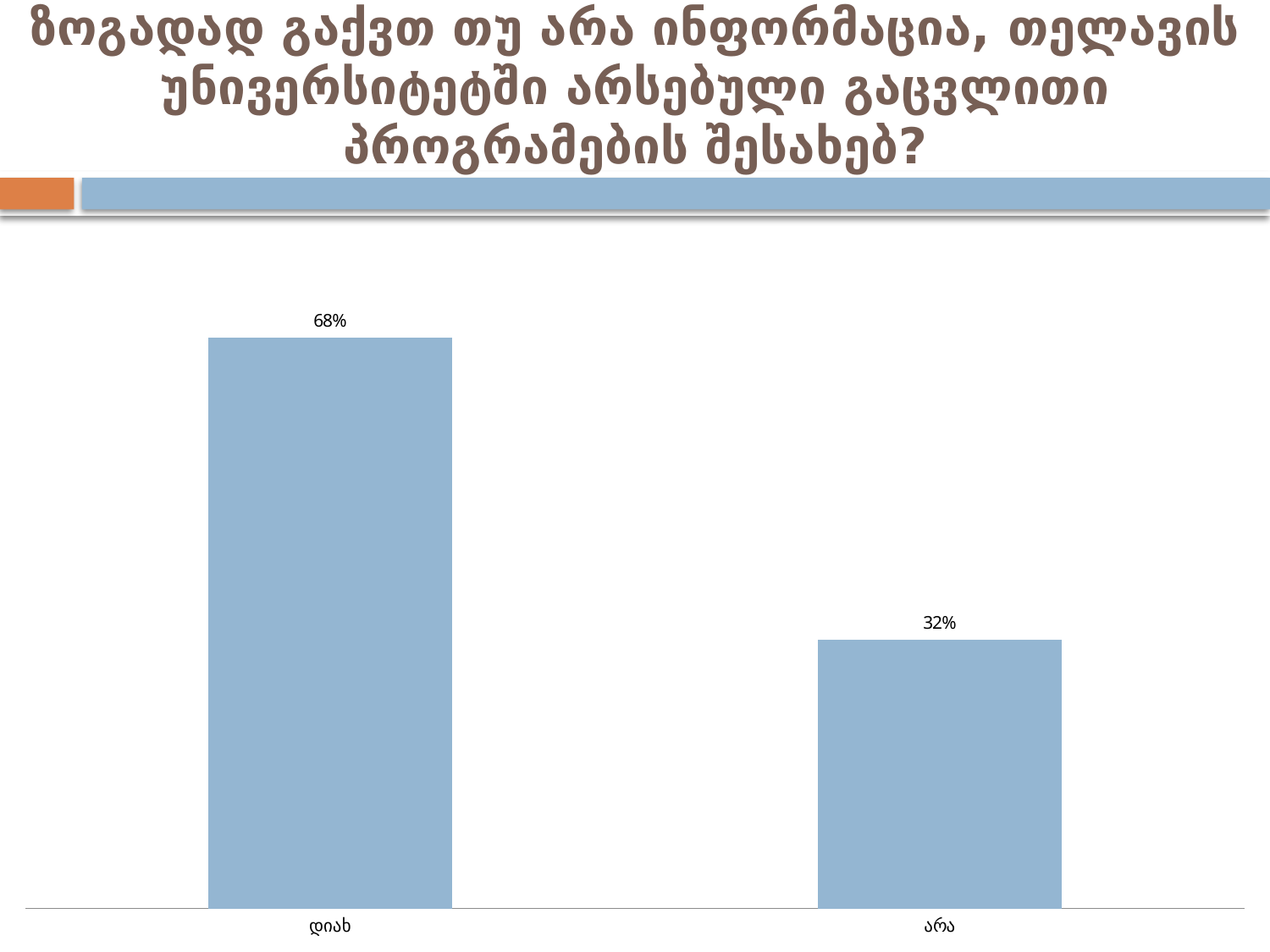
Which category has the lowest value? არა What is the total of the two values shown in the chart? 100% Do the values rise or fall from left to right along the x axis? fall What is the difference between the values for დიახ and არა? 36% What is the value for დიახ? 68% What colour are the bars in the chart? light blue Which category has the highest value? დიახ What is the value for არა? 32% Which is larger, the value for დიახ or the value for არა? დიახ What kind of chart is shown on the slide? bar chart How many categories are shown in the chart? 2